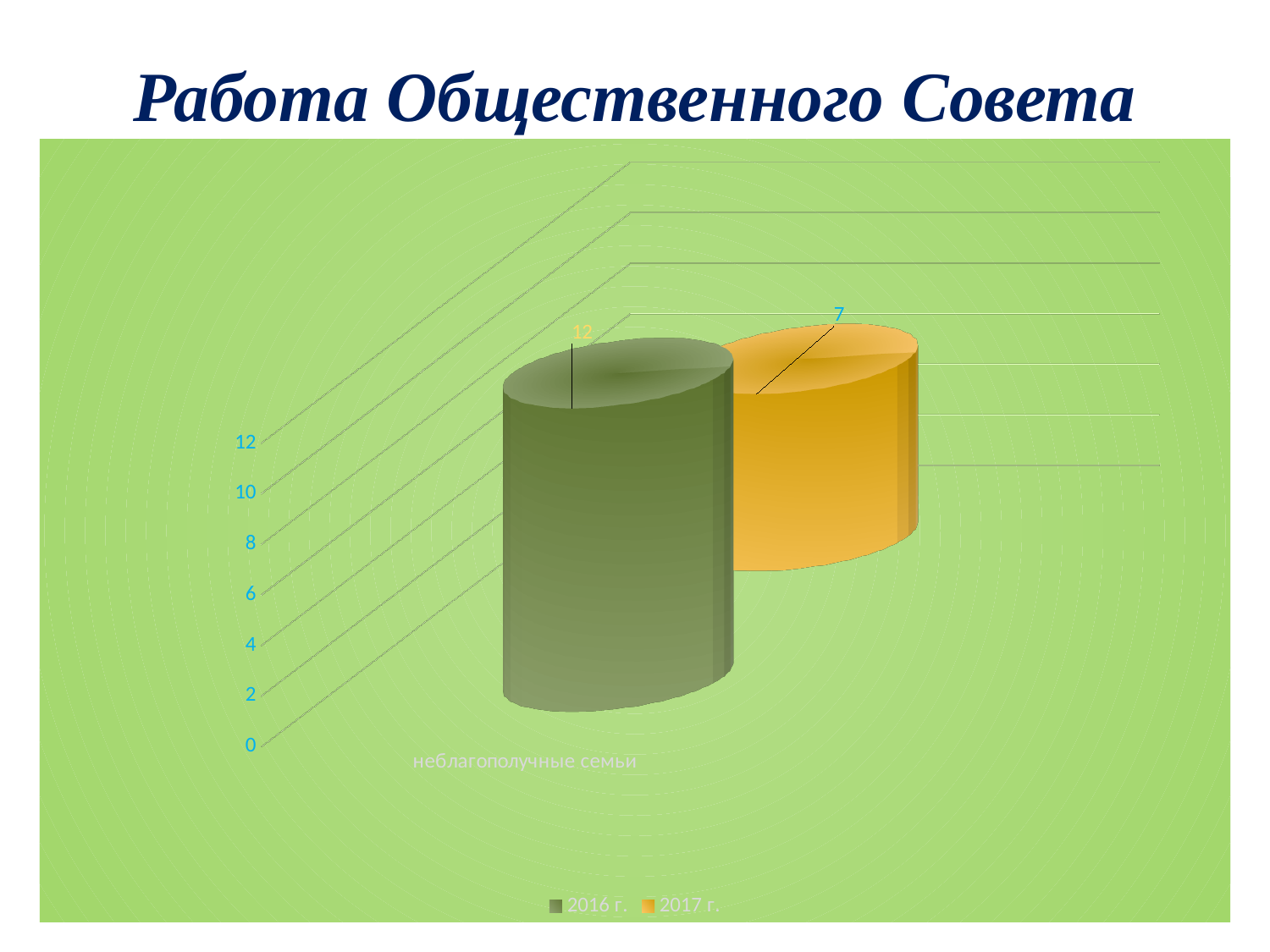
Is the value for 2017 г. greater or less than 10? less What is the difference between the 2016 г. and 2017 г. values for неблагополучные семьи? 5 What is the value for 2016 г. for неблагополучные семьи? 12 What is the title of the slide? Работа Общественного Совета How many series does the legend list? 2 Is the value for 2016 г. greater or less than 10? greater Which series has the higher value for неблагополучные семьи, 2016 г. or 2017 г.? 2016 г. What colour represents the 2017 г. series? orange What kind of chart is shown on the slide? bar chart What is the value for 2017 г. for неблагополучные семьи? 7 What is the category label on the x axis? неблагополучные семьи How many categories are shown on the x axis? 1